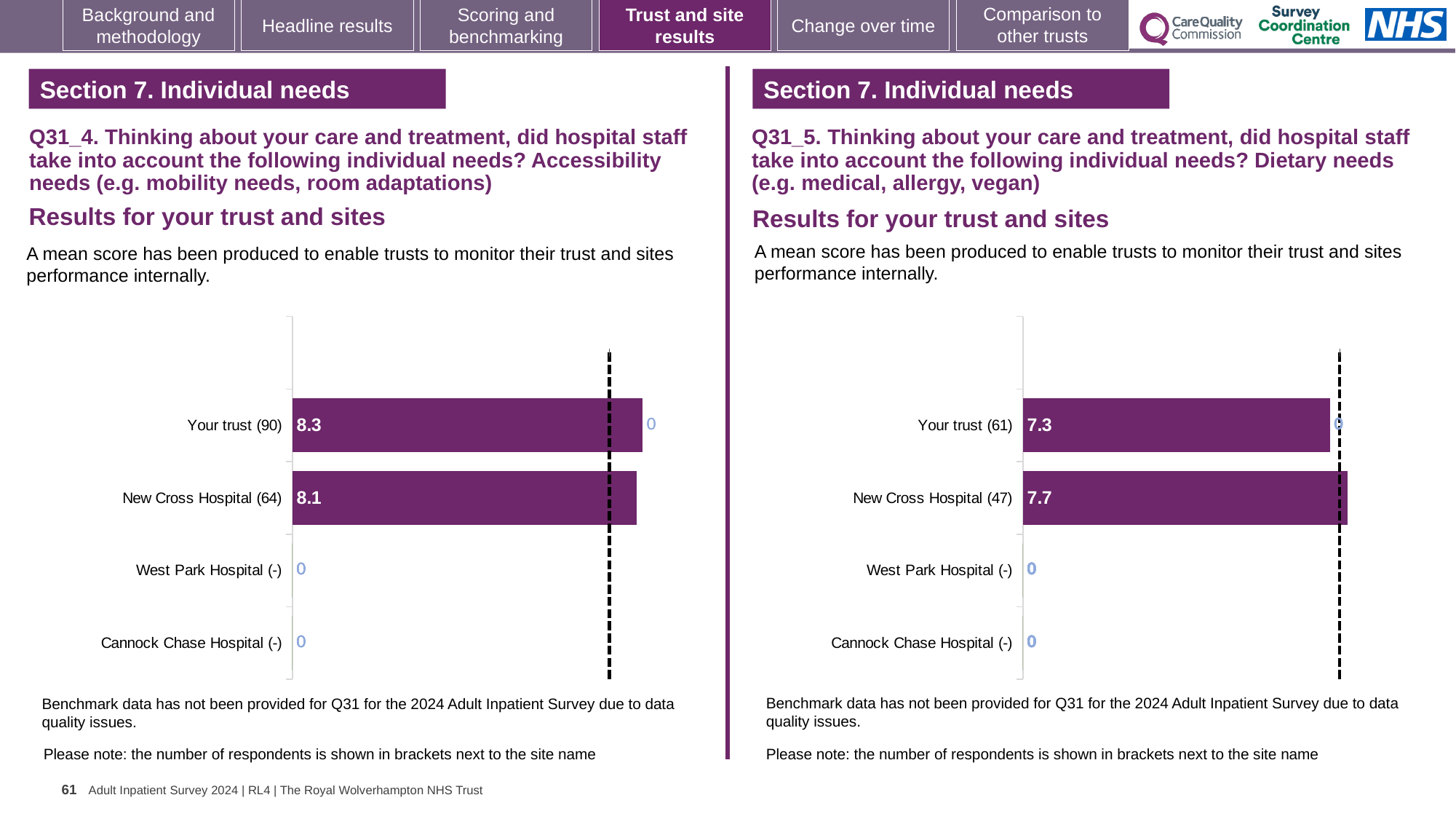
On the left chart (Q31_4, accessibility needs), what is the mean score for New Cross Hospital? 8.1 On the right chart (Q31_5, dietary needs), what is the mean score for New Cross Hospital? 7.7 On the right chart (Q31_5, dietary needs), which is larger: the score for Your trust or for New Cross Hospital? New Cross Hospital On the right chart (Q31_5, dietary needs), what is the mean score for Your trust? 7.3 On the right chart (Q31_5, dietary needs), which category has the highest mean score? New Cross Hospital On the left chart (Q31_4, accessibility needs), what is the mean score for Your trust? 8.3 On the right chart (Q31_5, dietary needs), what is the difference between the scores for New Cross Hospital and Your trust? 0.4 How many categories are shown on the left chart (Q31_4, accessibility needs)? 4 On the left chart (Q31_4, accessibility needs), how many respondents are shown in brackets for Your trust? 90 What type of chart is used on the right side of the slide (Q31_5, dietary needs)? Bar chart On the left chart (Q31_4, accessibility needs), what is the difference between the scores for Your trust and New Cross Hospital? 0.2 On the left chart (Q31_4, accessibility needs), which category has the highest mean score? Your trust